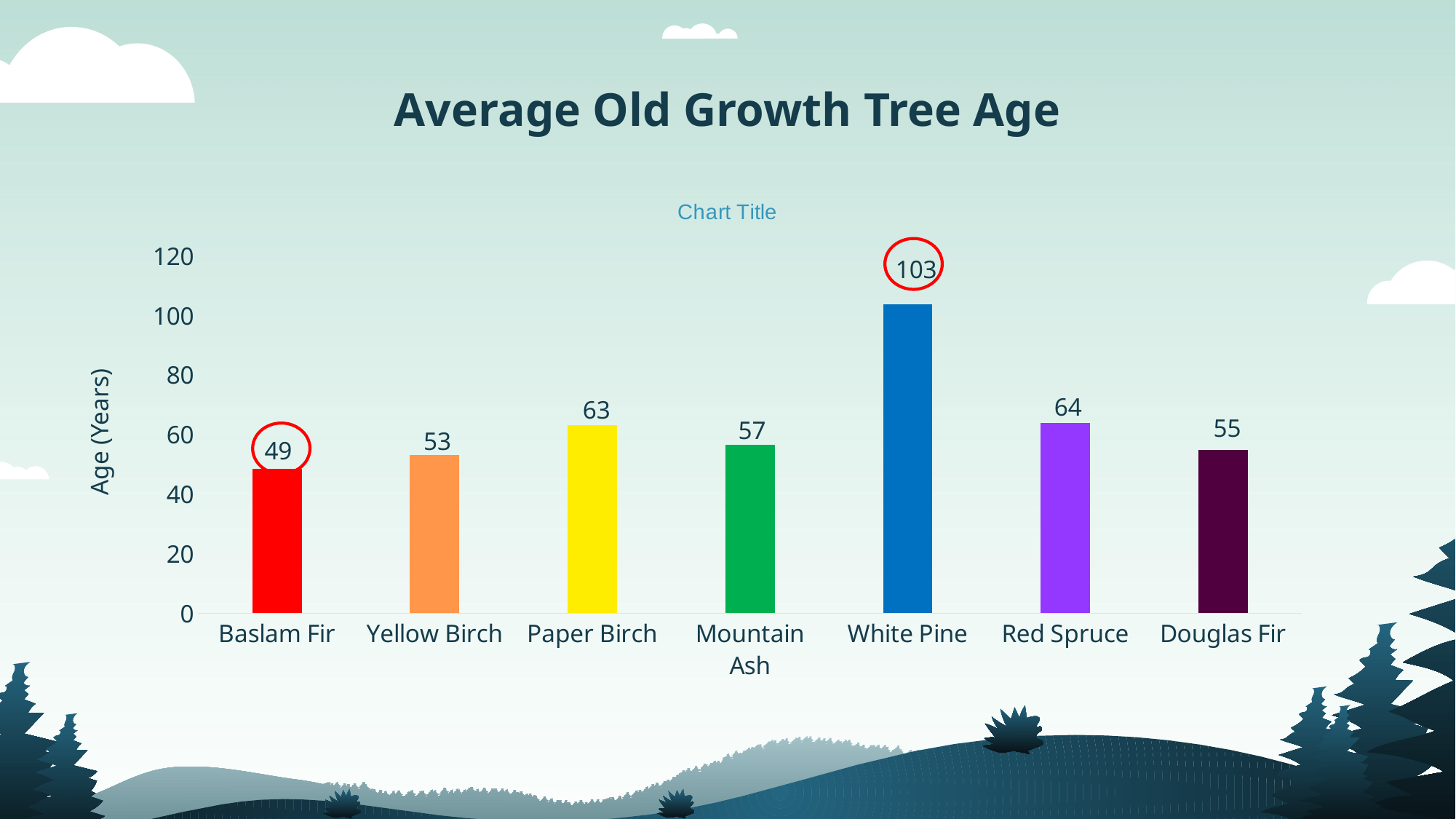
What is the average age shown for Mountain Ash? 57 What is the average age shown for Douglas Fir? 55 What is the average age shown for White Pine? 103 Which tree has the highest average old growth age? White Pine Which tree has the lowest average old growth age? Baslam Fir What kind of chart is shown on the slide? Bar chart Is the value for White Pine greater or less than 100? greater How many tree species are shown on the chart? 7 What is the label on the vertical axis of the chart? Age (Years) What is the difference in average age between Red Spruce and Yellow Birch? 11 Which has a higher average age, Paper Birch or Douglas Fir? Paper Birch What is the difference in average age between White Pine and Baslam Fir? 54